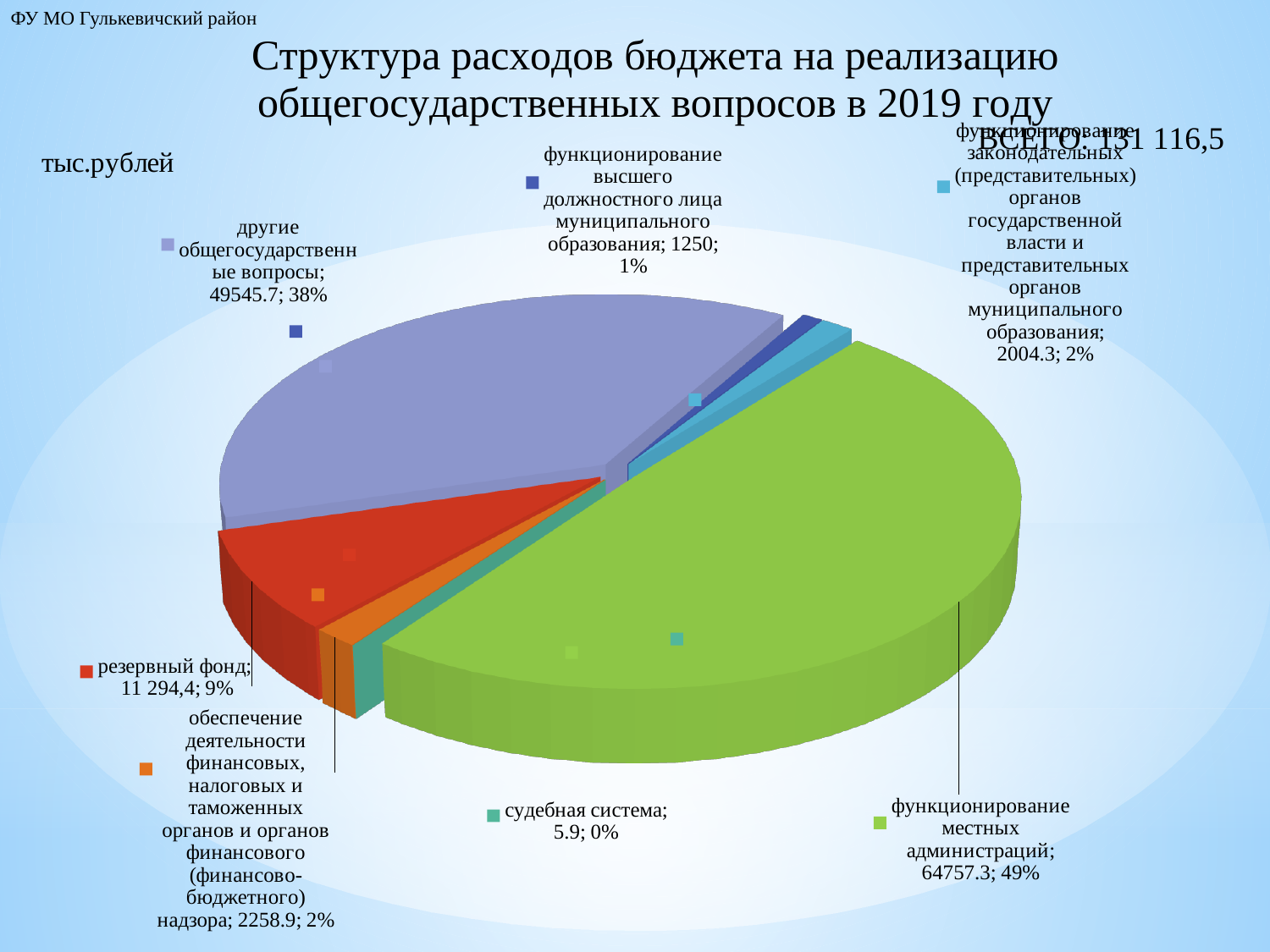
What kind of chart is shown on the slide? pie chart What is the value for функционирование местных администраций? 64757.3 Which is larger: the value for резервный фонд or the value for обеспечение деятельности финансовых, налоговых и таможенных органов и органов финансового (финансово-бюджетного) надзора? резервный фонд How many categories (slices) does the pie chart have? 7 What is the difference between the values for функционирование местных администраций and другие общегосударственные вопросы? 15211.6 Which category has the smallest slice of the pie? судебная система What is the value for резервный фонд? 11 294,4 What is the value for функционирование высшего должностного лица муниципального образования? 1250 What share of the pie does другие общегосударственные вопросы represent? 38% Which category has the largest slice of the pie? функционирование местных администраций What is the value for судебная система? 5.9 What total (ВСЕГО) is shown on the slide? 131 116,5